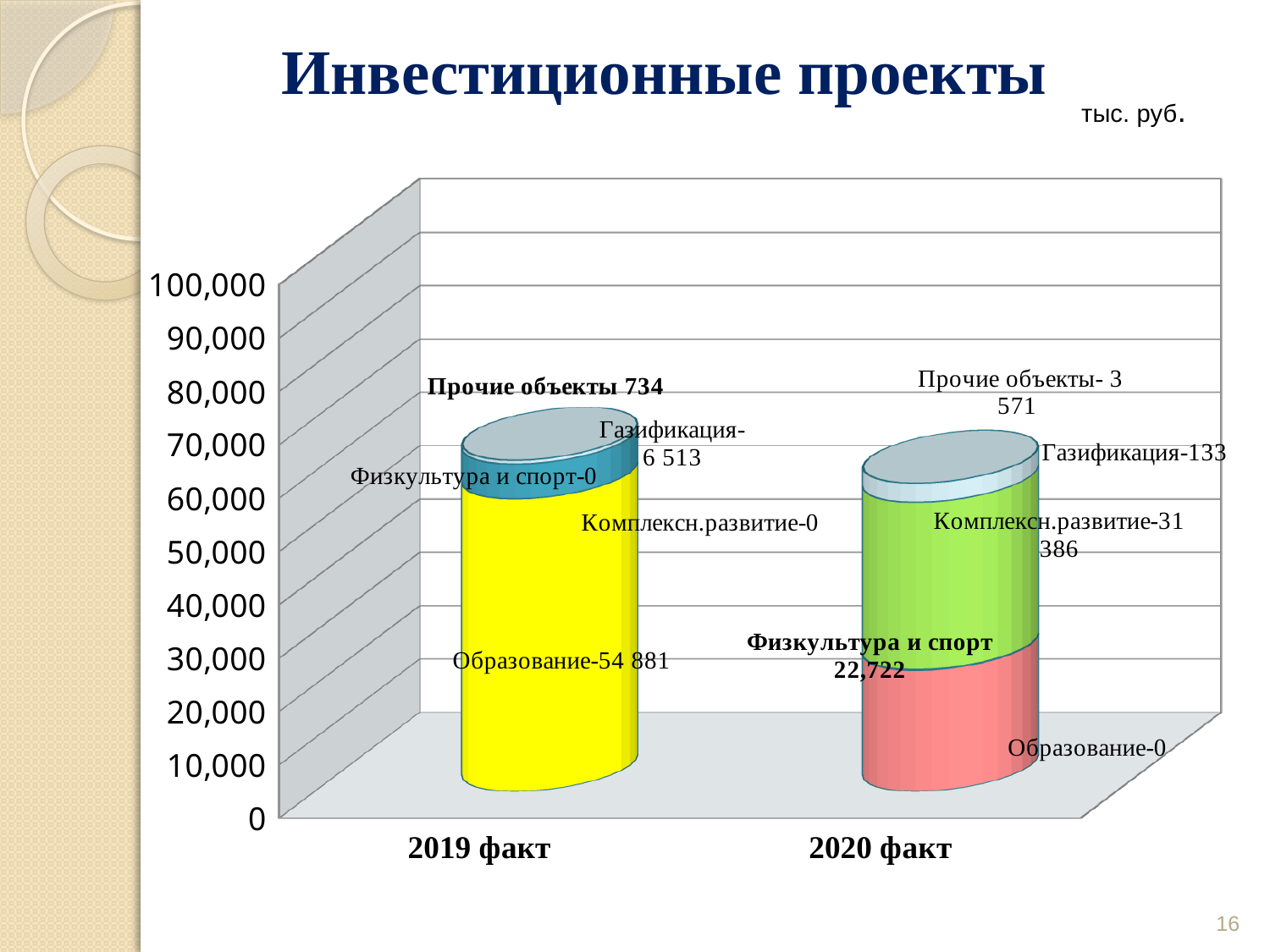
What is the value for Образование in 2020 факт? 0 What is the value for Физкультура и спорт in 2020 факт? 22,722 What is the value for Образование in 2019 факт? 54 881 What is the value for Газификация in 2019 факт? 6 513 Which is larger in 2020 факт: Комплексн.развитие or Физкультура и спорт? Комплексн.развитие What is the value for Прочие объекты in 2020 факт? 3 571 What is the difference between Газификация in 2019 факт and Газификация in 2020 факт? 6 380 What is the value for Комплексн.развитие in 2020 факт? 31 386 What kind of chart is shown on the slide? Stacked bar chart How many categories are shown on the x axis? 2 What is the total of the stacked bar for 2019 факт? 62 128 What is the title of the chart? Инвестиционные проекты